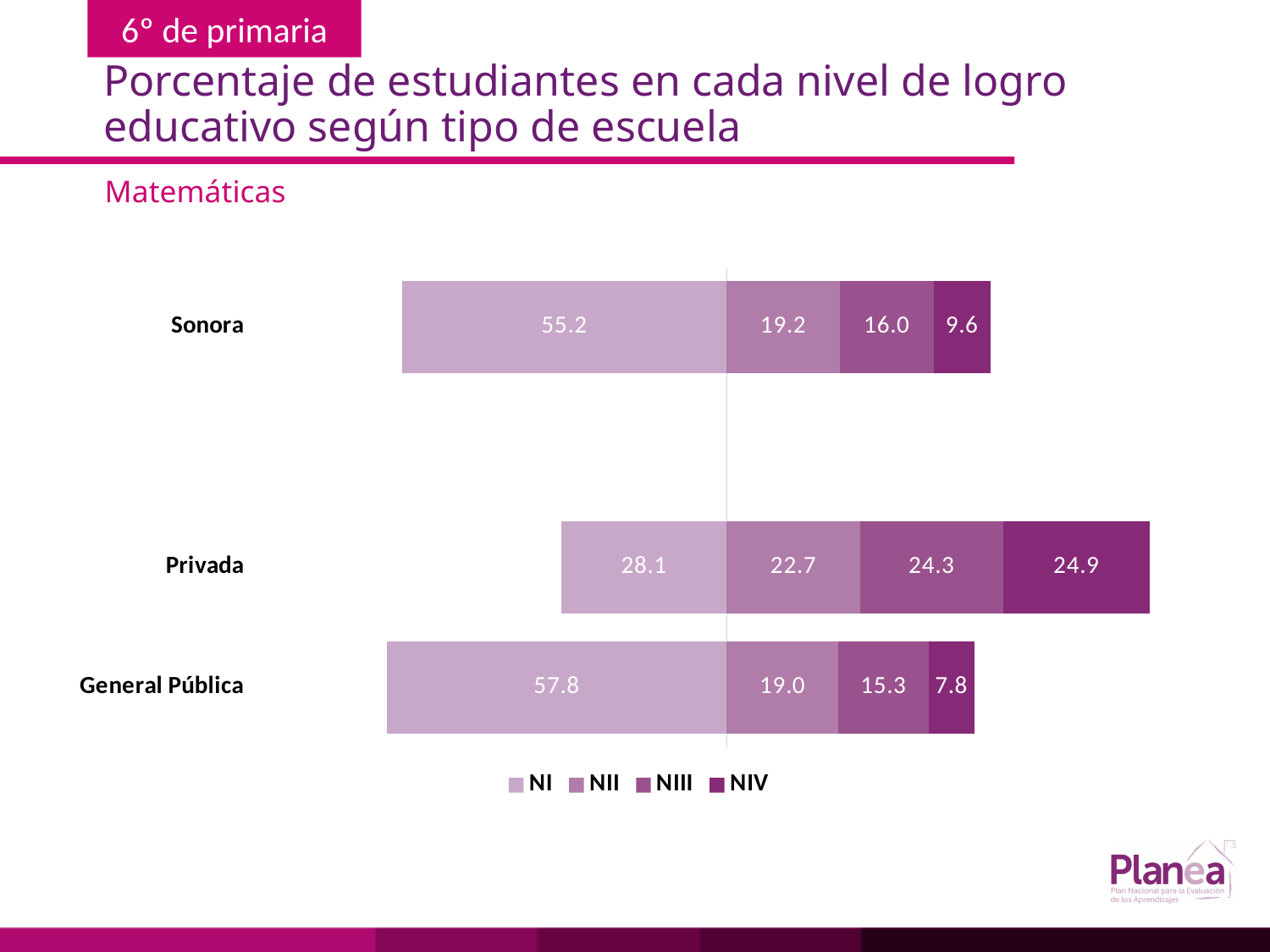
How many series does the legend list? 4 What is the difference between the NI values for General Pública and Sonora? 2.6 What is the NI value for Sonora? 55.2 What is the NIV value for Privada? 24.9 What is the NII value for Privada? 22.7 How many categories are shown on the chart? 3 Which is larger, the NIII value for Privada or the NIII value for Sonora? Privada Which category has the highest NI value? General Pública Which category has the lowest NIV value? General Pública What is the total of the stacked bar for Sonora? 100.0 What kind of chart is shown on the slide? Stacked bar chart What is the NIII value for General Pública? 15.3